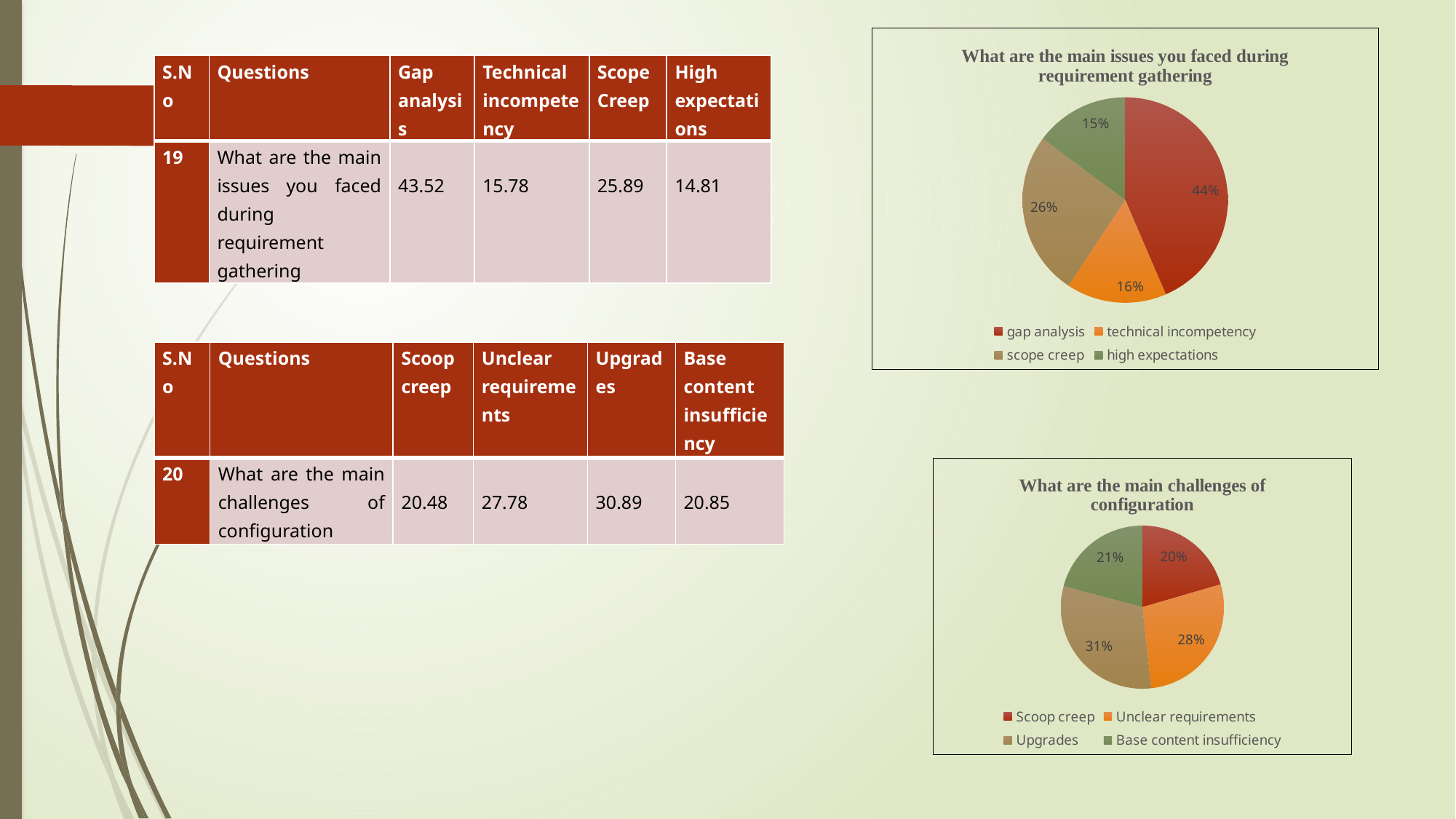
In the chart titled "What are the main issues you faced during requirement gathering", which category has the largest slice? gap analysis In the chart titled "What are the main challenges of configuration", what is the difference in percentage points between Upgrades and Scoop creep? 11 In the chart titled "What are the main challenges of configuration", what share do Upgrades have? 31% In the chart titled "What are the main issues you faced during requirement gathering", what share does scope creep have? 26% In the chart titled "What are the main issues you faced during requirement gathering", what is the difference in percentage points between gap analysis and technical incompetency? 28 In the chart titled "What are the main issues you faced during requirement gathering", how many categories does the legend list? 4 In the chart titled "What are the main challenges of configuration", which category has the largest slice? Upgrades In the chart titled "What are the main issues you faced during requirement gathering", which category has the smallest slice? high expectations In the chart titled "What are the main challenges of configuration", what share does Base content insufficiency have? 21% In the chart titled "What are the main challenges of configuration", which is larger: Unclear requirements or Scoop creep? Unclear requirements In the chart titled "What are the main issues you faced during requirement gathering", what share does gap analysis have? 44% What kind of chart is the one titled "What are the main challenges of configuration"? pie chart